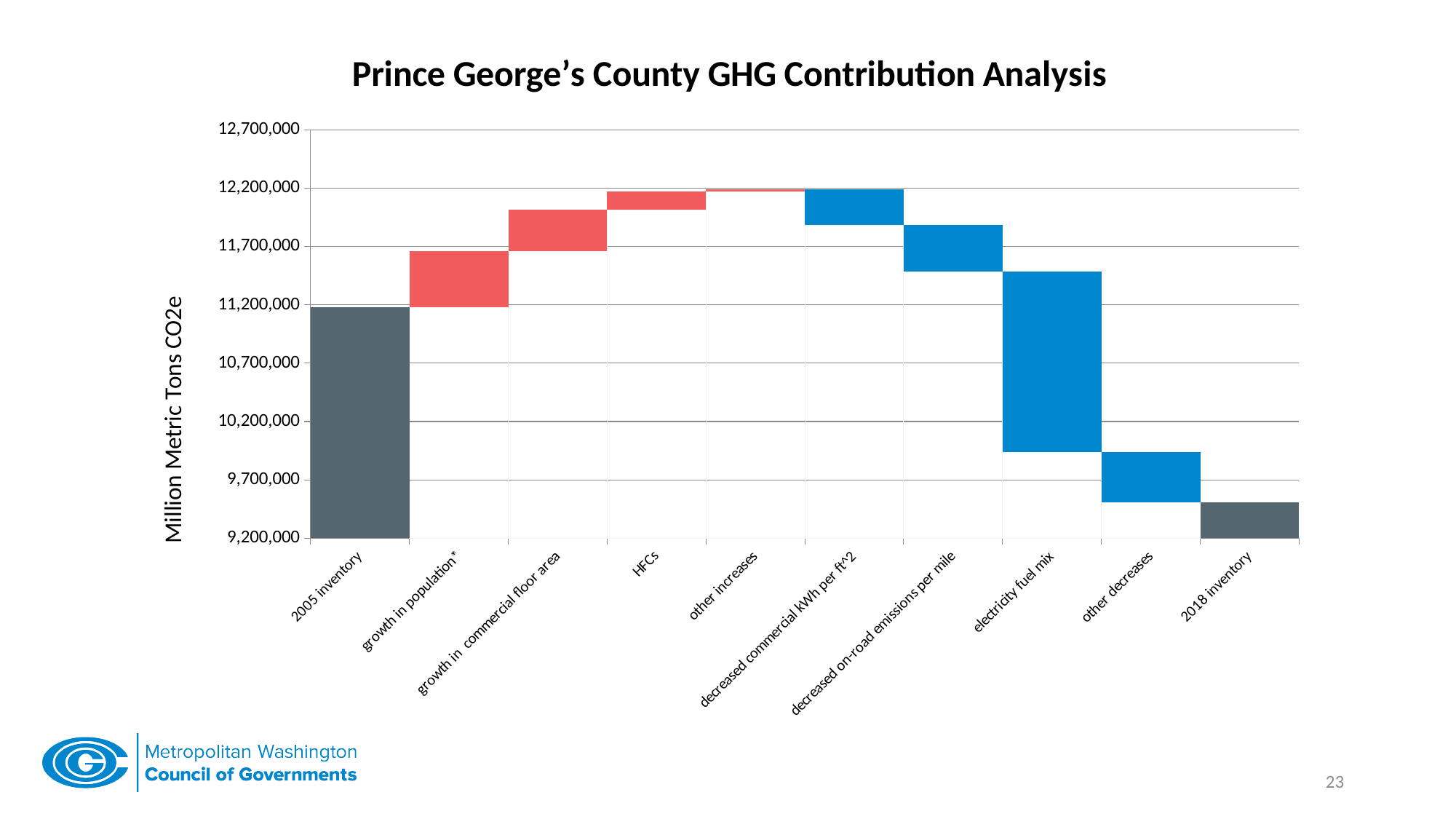
What kind of chart is shown on the slide? bar chart Is the value for the 2018 inventory greater or less than 9,700,000? less Which is larger, the 2005 inventory or the 2018 inventory? 2005 inventory Is the value for the 2018 inventory greater or less than 9,200,000? greater Which category represents the smallest change in emissions? other increases What is the title of the chart? Prince George's County GHG Contribution Analysis Did total emissions rise or fall from the 2005 inventory to the 2018 inventory? fall What is the label on the vertical axis of the chart? Million Metric Tons CO2e How many categories are shown along the x axis of the chart? 10 Which contributes a larger increase, growth in population or growth in commercial floor area? growth in population Is the value for the 2005 inventory greater or less than 10,700,000? greater Which category represents the largest decrease in emissions? electricity fuel mix